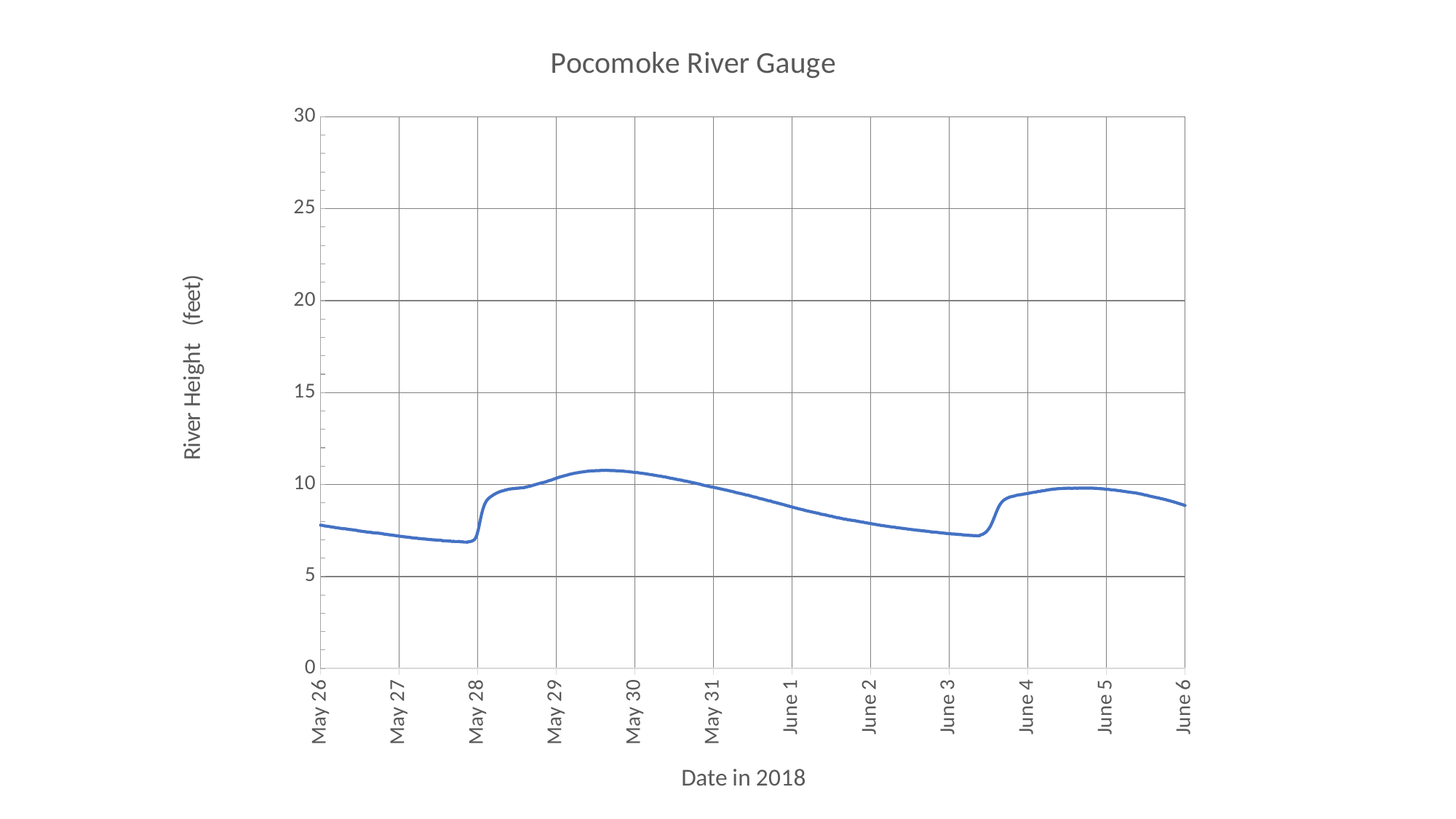
Does the river height ever rise above 15 feet during the period shown? No What kind of chart is shown on the slide? line chart How many date labels are shown on the horizontal axis? 12 Is the river height on May 26 greater or less than 10 feet? less What is the label of the vertical axis? River Height (feet) What is the title of the chart? Pocomoke River Gauge Is the river height on June 3 greater or less than 10 feet? less Does the river height rise or fall between May 26 and the start of May 28? fall Does the river height rise or fall between May 30 and June 3? fall Is the river height higher on May 30 or on June 3? May 30